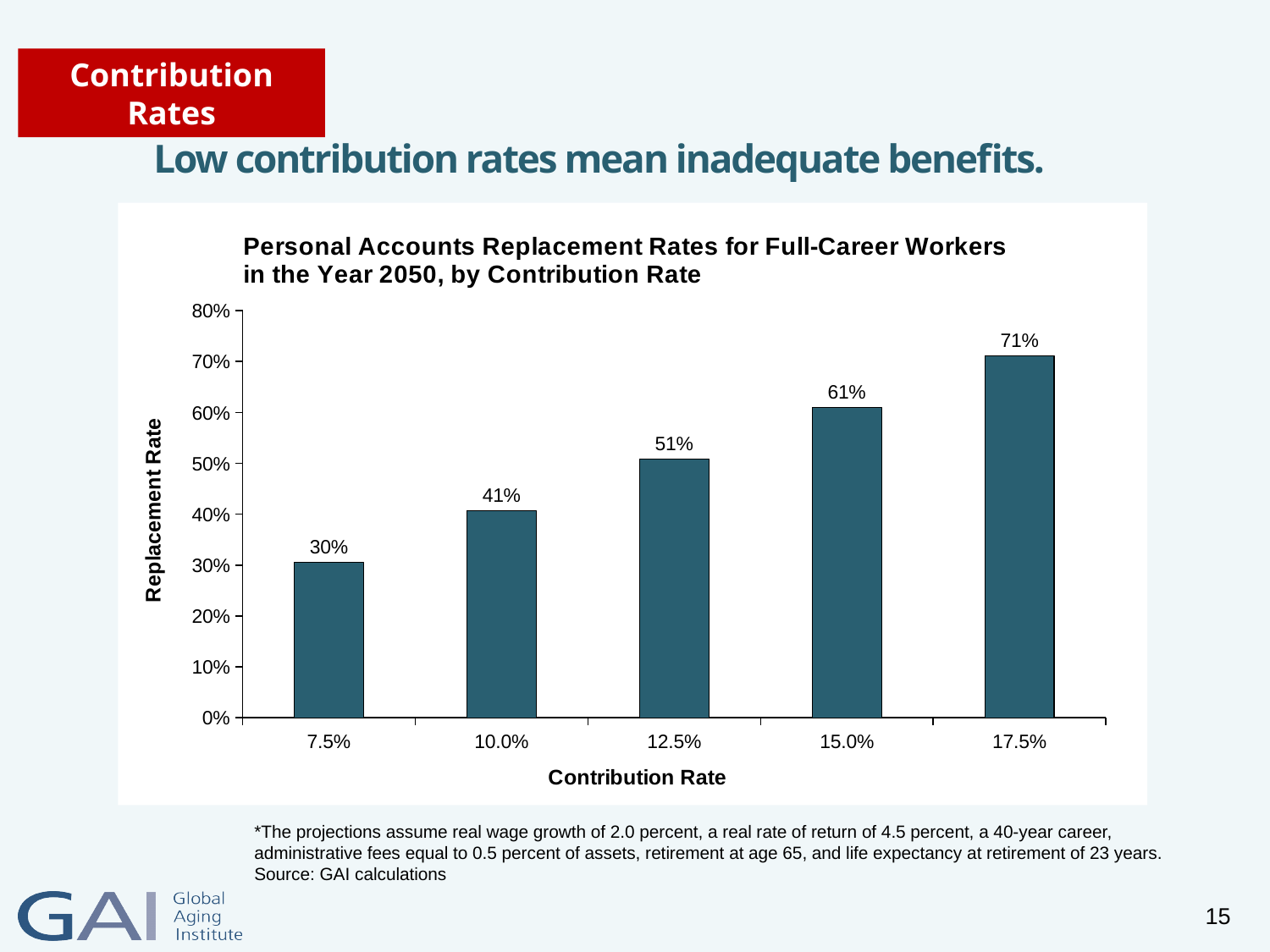
Which has a higher replacement rate: a 10.0% or a 12.5% contribution rate? 12.5% Which contribution rate has the lowest replacement rate? 7.5% How many contribution rates are shown on the chart? 5 What is the replacement rate for a 12.5% contribution rate? 51% What is the label of the vertical axis of the chart? Replacement Rate Do replacement rates rise or fall as the contribution rate increases? Rise Is the replacement rate for a 15.0% contribution rate greater or less than 50%? greater What is the replacement rate for a 17.5% contribution rate? 71% What is the difference in replacement rate between the 15.0% and 10.0% contribution rates? 20% What kind of chart is shown on the slide? Bar chart What is the replacement rate for a 7.5% contribution rate? 30% Which contribution rate has the highest replacement rate? 17.5%